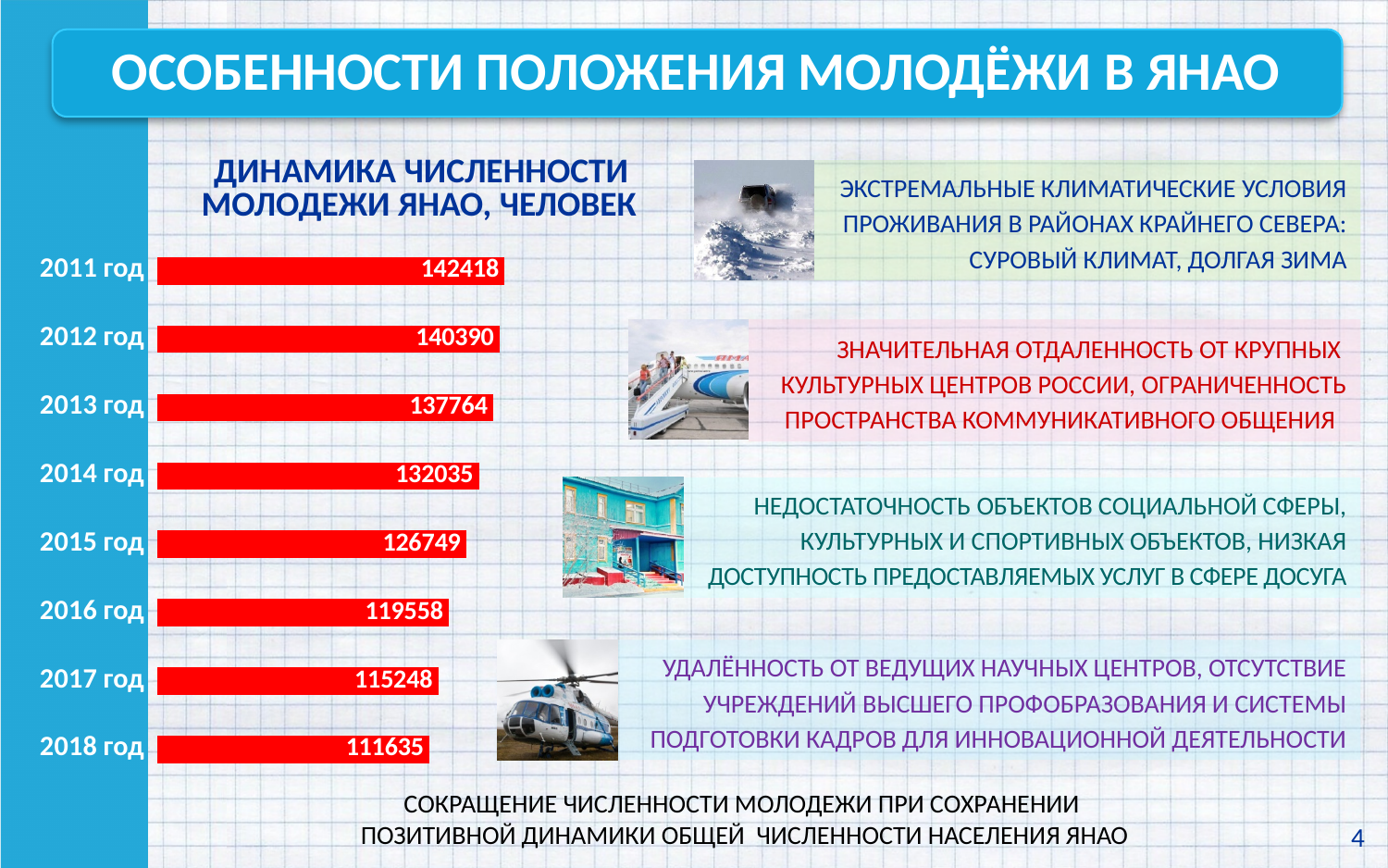
What is the title of the chart? ДИНАМИКА ЧИСЛЕННОСТИ МОЛОДЕЖИ ЯНАО, ЧЕЛОВЕК How many years are shown in the chart? 8 What is the value for 2015 год? 126749 What is the difference between the values for 2011 год and 2018 год? 30783 What kind of chart is shown on the slide? bar chart What is the difference between the values for 2013 год and 2014 год? 5729 Which year has the highest value? 2011 год Do the values rise or fall from 2011 год to 2018 год? fall What is the value for 2011 год? 142418 Which is larger, the value for 2012 год or the value for 2016 год? 2012 год What is the value for 2018 год? 111635 Which year has the lowest value? 2018 год